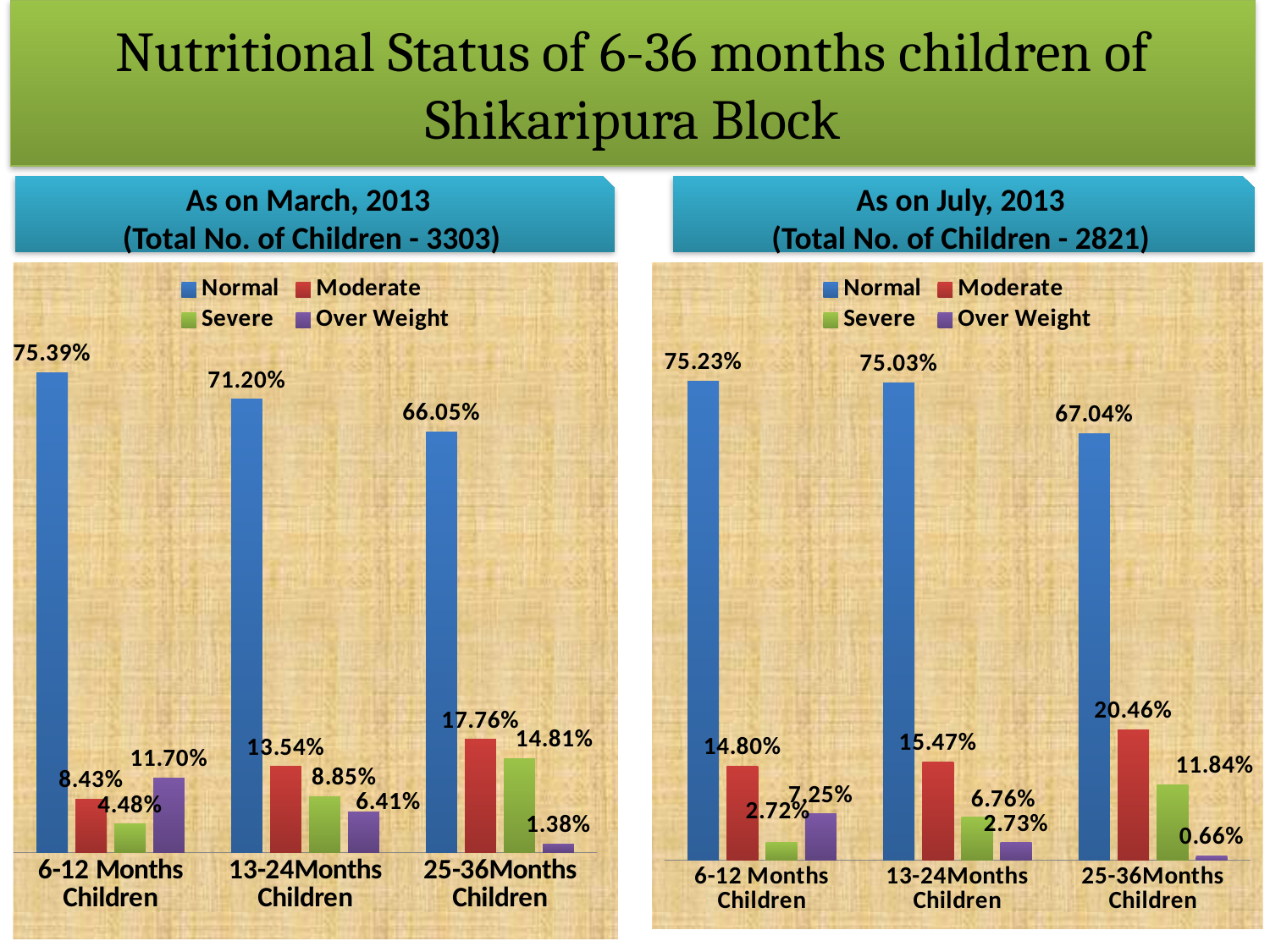
How many series does the legend of the 'As on March, 2013' chart list? 4 In the 'As on March, 2013' chart, what is the difference between the Normal values for 6-12 Months Children and 25-36 Months Children? 9.34% What type of chart is the 'As on March, 2013' chart? Bar chart How many age-group categories are shown in the 'As on July, 2013' chart? 3 In the 'As on July, 2013' chart, which is larger: the Severe value for 6-12 Months Children or the Severe value for 25-36 Months Children? 25-36 Months Children In the 'As on July, 2013' chart, which age group has the lowest Over Weight value? 25-36 Months Children In the 'As on July, 2013' chart, do the Normal values rise or fall from 6-12 Months Children to 25-36 Months Children? Fall In the 'As on March, 2013' chart, what is the Normal value for 6-12 Months Children? 75.39% In the 'As on July, 2013' chart, what is the Moderate value for 25-36 Months Children? 20.46% In the 'As on March, 2013' chart, which age group has the highest Moderate value? 25-36 Months Children In the 'As on March, 2013' chart, what is the Over Weight value for 25-36 Months Children? 1.38% In the 'As on July, 2013' chart, what is the Severe value for 13-24 Months Children? 6.76%